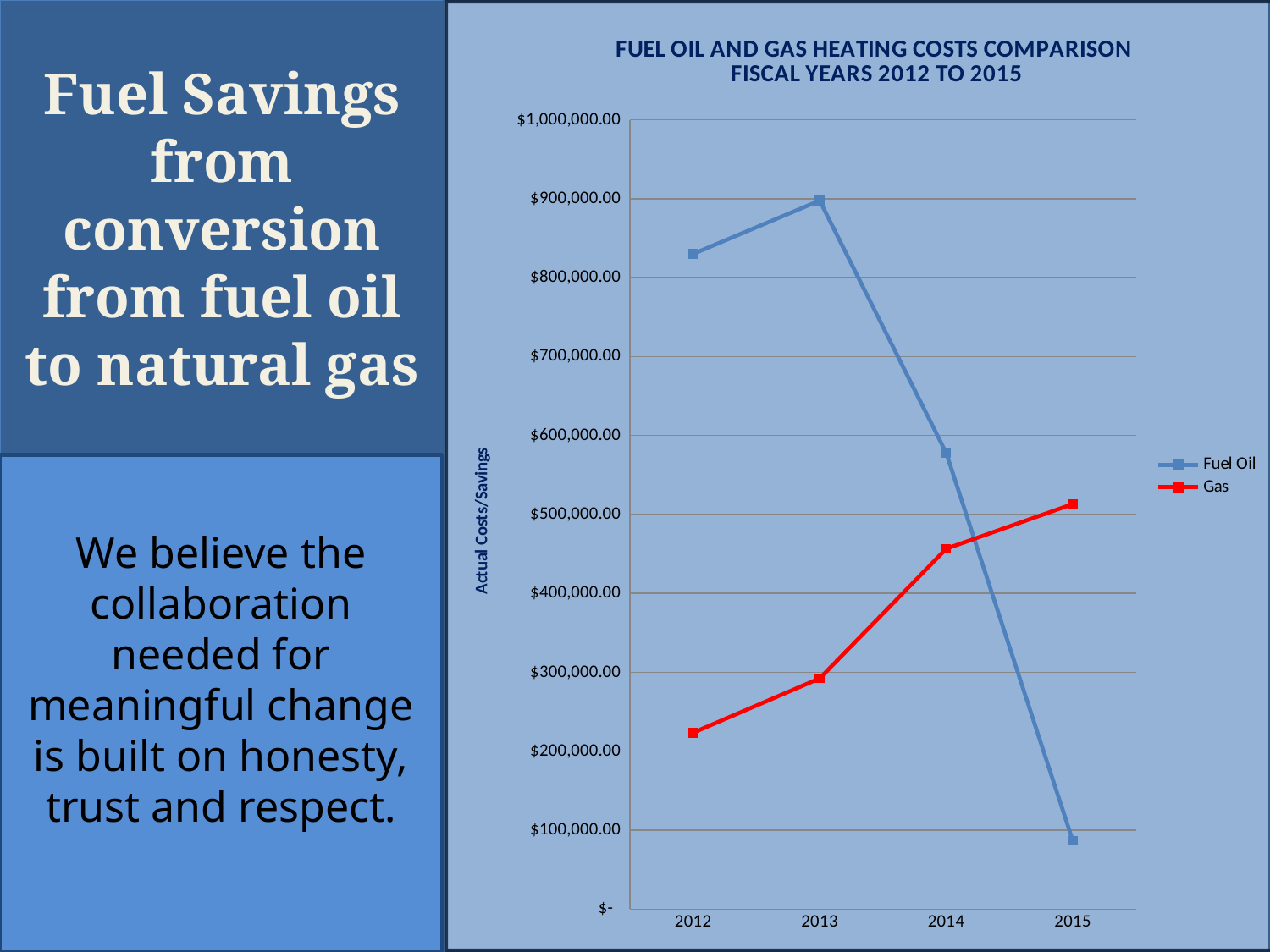
Is the Fuel Oil value for 2015 greater or less than $100,000.00? less In which year is the Fuel Oil cost lowest? 2015 Which series has the larger value in 2015, Fuel Oil or Gas? Gas What is the title of the chart? FUEL OIL AND GAS HEATING COSTS COMPARISON FISCAL YEARS 2012 TO 2015 Is the Gas value for 2014 greater or less than $400,000.00? greater What kind of chart is shown on the slide? Line chart How many fiscal years are plotted along the x axis? 4 How many series does the legend list? 2 Is the Fuel Oil value for 2014 greater or less than $600,000.00? less In which year is the Gas cost lowest? 2012 Does the Gas series rise or fall from 2012 to 2015? Rise In which year is the Fuel Oil cost highest? 2013